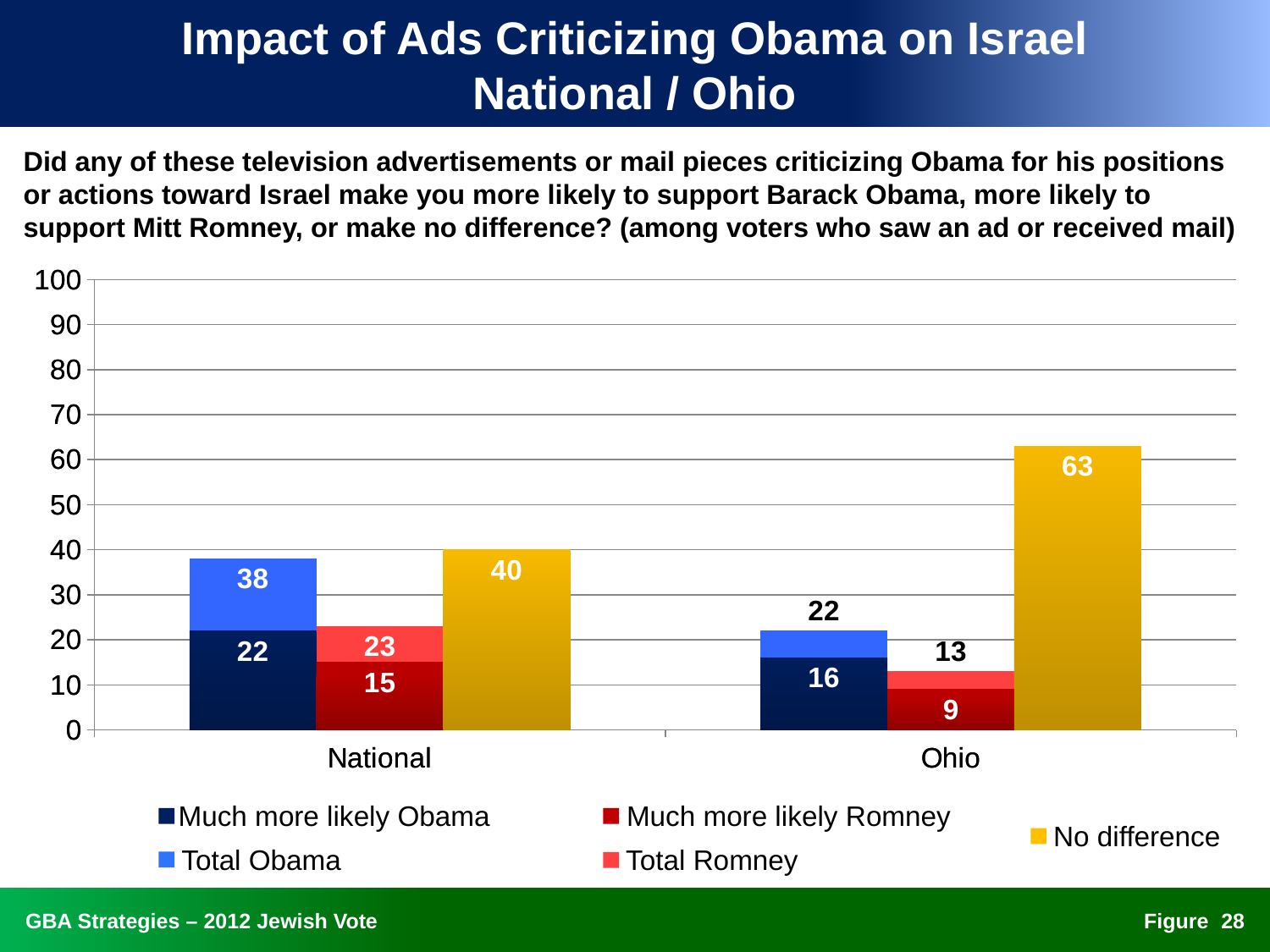
What is the value for Total Obama in the National category? 38 Which series has the lowest value in Ohio? Much more likely Romney Which category has the higher value for No difference, National or Ohio? Ohio How many categories are shown on the x axis? 2 What is the value for Total Romney in the National category? 23 How many series does the legend list? 5 What kind of chart is shown on the slide? Bar chart What is the value for Much more likely Romney in Ohio? 9 What is the difference between No difference in Ohio and No difference in the National category? 23 Which series has the highest value in the National category? No difference What is the value for No difference in Ohio? 63 What is the difference between Total Obama and Much more likely Obama in the National category? 16